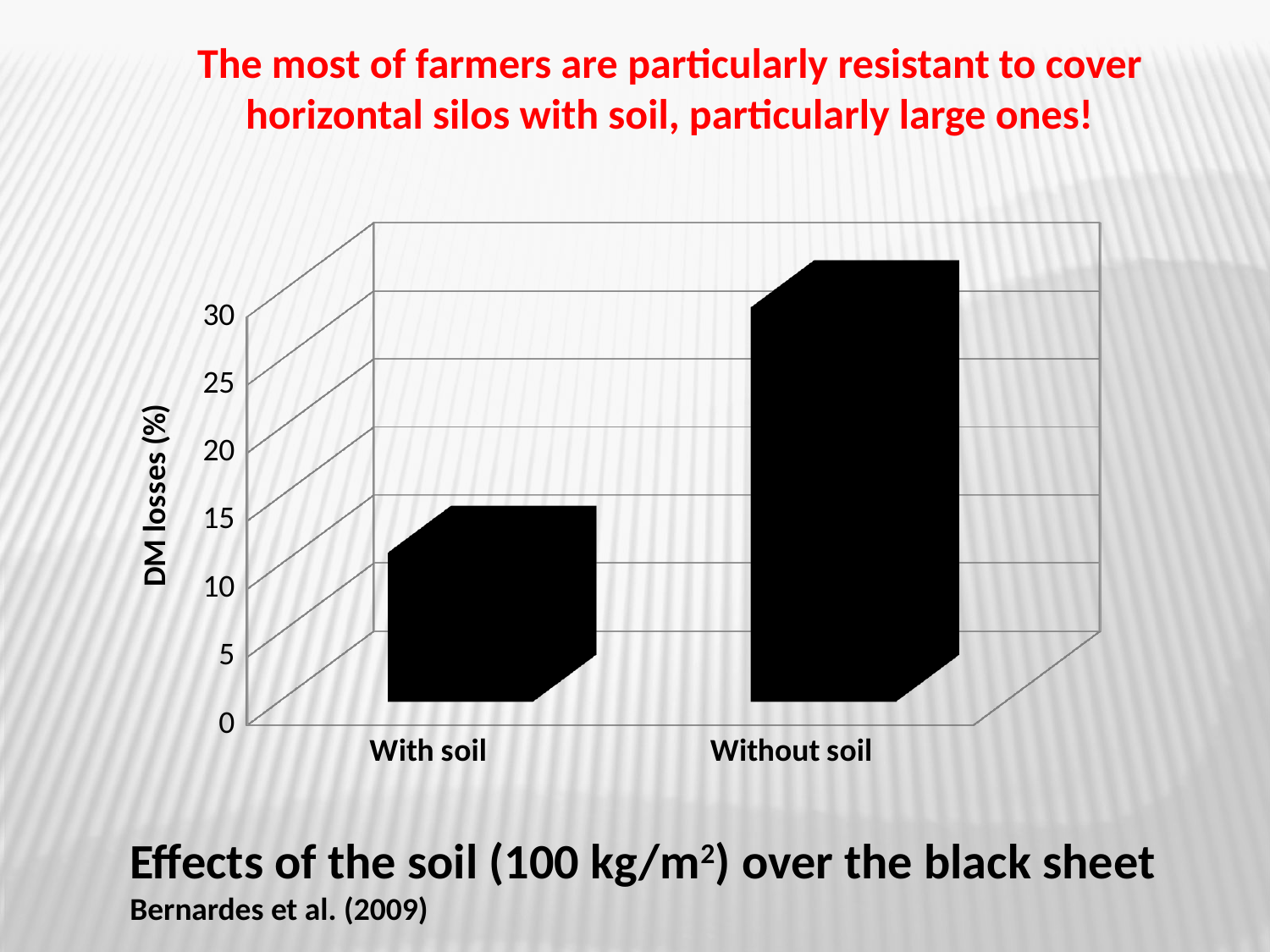
What is the label of the vertical axis of the chart? DM losses (%) Which category has the lowest DM losses? With soil Is the value for Without soil greater or less than 20? greater What kind of chart is shown on the slide? bar chart Is the value for With soil greater or less than 20? less Which has larger DM losses, With soil or Without soil? Without soil Is the value for With soil greater or less than 5? greater Which category has the highest DM losses? Without soil How many categories are plotted on the x axis of the chart? 2 What colour are the bars in the chart? black